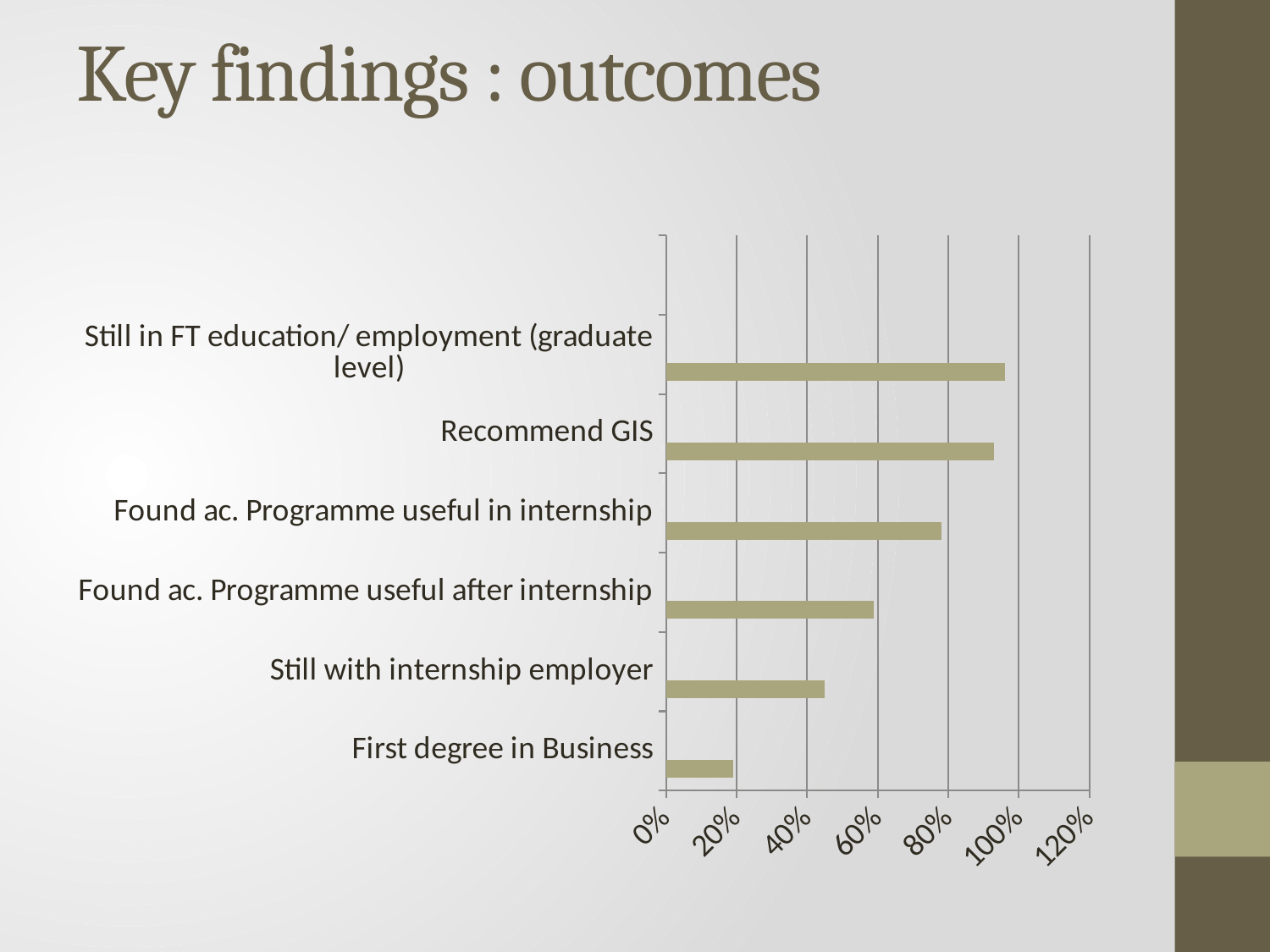
Is the value for 'Recommend GIS' greater or less than 80%? greater Which is larger: the value for 'Found ac. Programme useful in internship' or 'Found ac. Programme useful after internship'? Found ac. Programme useful in internship Is the value for 'Still with internship employer' greater or less than 60%? less Is the value for 'First degree in Business' greater or less than 40%? less Which category has the lowest value in the chart? First degree in Business Which is larger: the value for 'Still with internship employer' or 'First degree in Business'? Still with internship employer Which category has the highest value in the chart? Still in FT education/ employment (graduate level) What kind of chart is shown on the slide? bar chart How many categories are plotted in the chart? 6 What is the title of the slide containing the chart? Key findings : outcomes